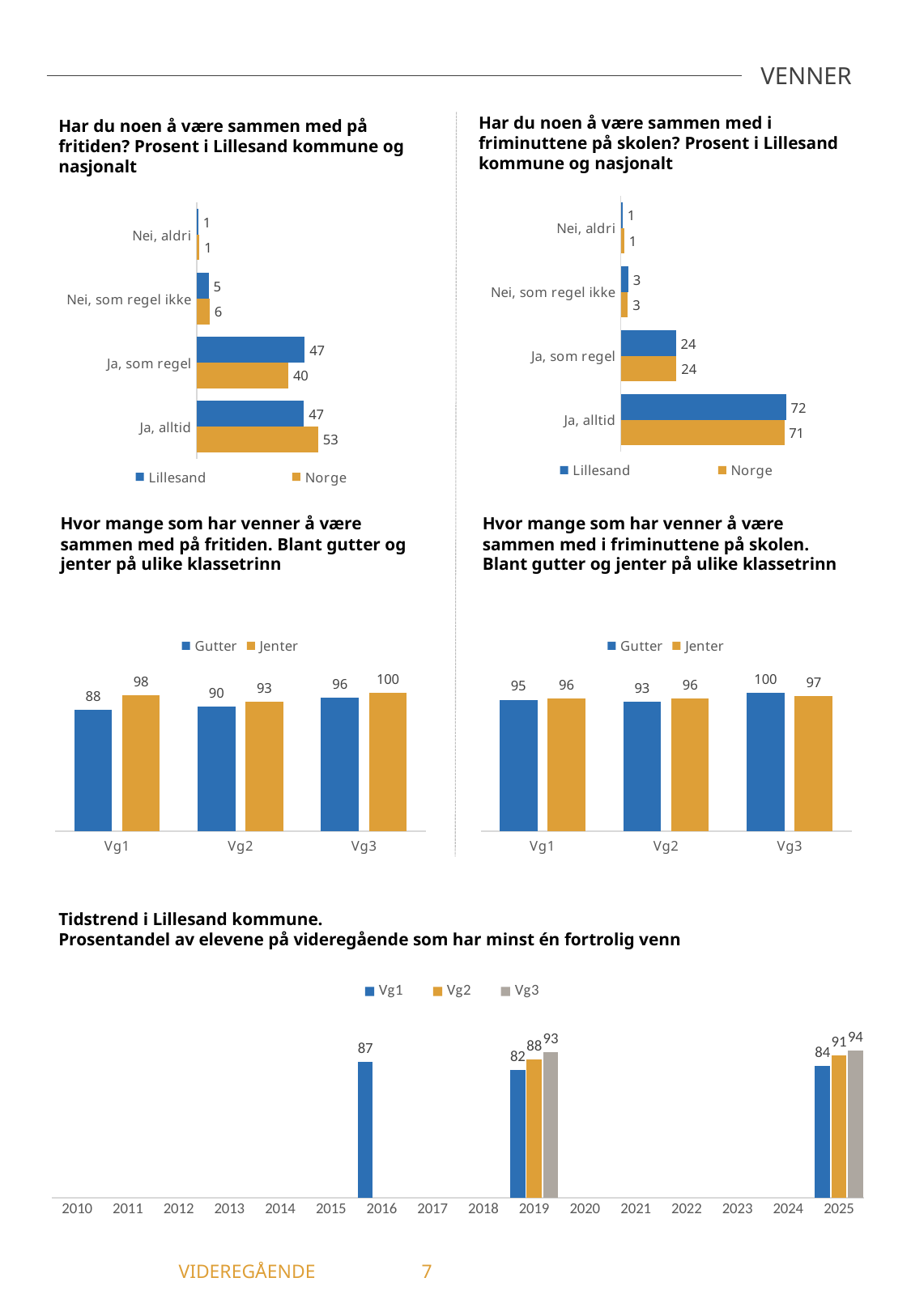
In the chart 'Har du noen å være sammen med på fritiden?', what is the difference between Lillesand and Norge for 'Ja, som regel'? 7 In the chart 'Har du noen å være sammen med i friminuttene på skolen?', what is the value for Lillesand in the category 'Ja, alltid'? 72 In the chart 'Tidstrend i Lillesand kommune', what kind of chart is it? Bar chart In the chart 'Hvor mange som har venner å være sammen med på fritiden', which group has the highest value? Jenter at Vg3 In the chart 'Har du noen å være sammen med på fritiden?', what is the value for Norge in the category 'Ja, alltid'? 53 In the chart 'Har du noen å være sammen med på fritiden?', how many series does the legend list? 2 In the chart 'Har du noen å være sammen med i friminuttene på skolen?', how many categories are shown? 4 In the chart 'Har du noen å være sammen med i friminuttene på skolen?', which category has the lowest value for Norge? Nei, aldri In the chart 'Hvor mange som har venner å være sammen med i friminuttene på skolen', which is larger at Vg3: Gutter or Jenter? Gutter In the chart 'Hvor mange som har venner å være sammen med på fritiden', what is the value for Jenter at Vg1? 98 In the chart 'Hvor mange som har venner å være sammen med i friminuttene på skolen', what is the difference between Jenter and Gutter at Vg2? 3 In the chart 'Tidstrend i Lillesand kommune', what is the value for Vg3 in 2025? 94